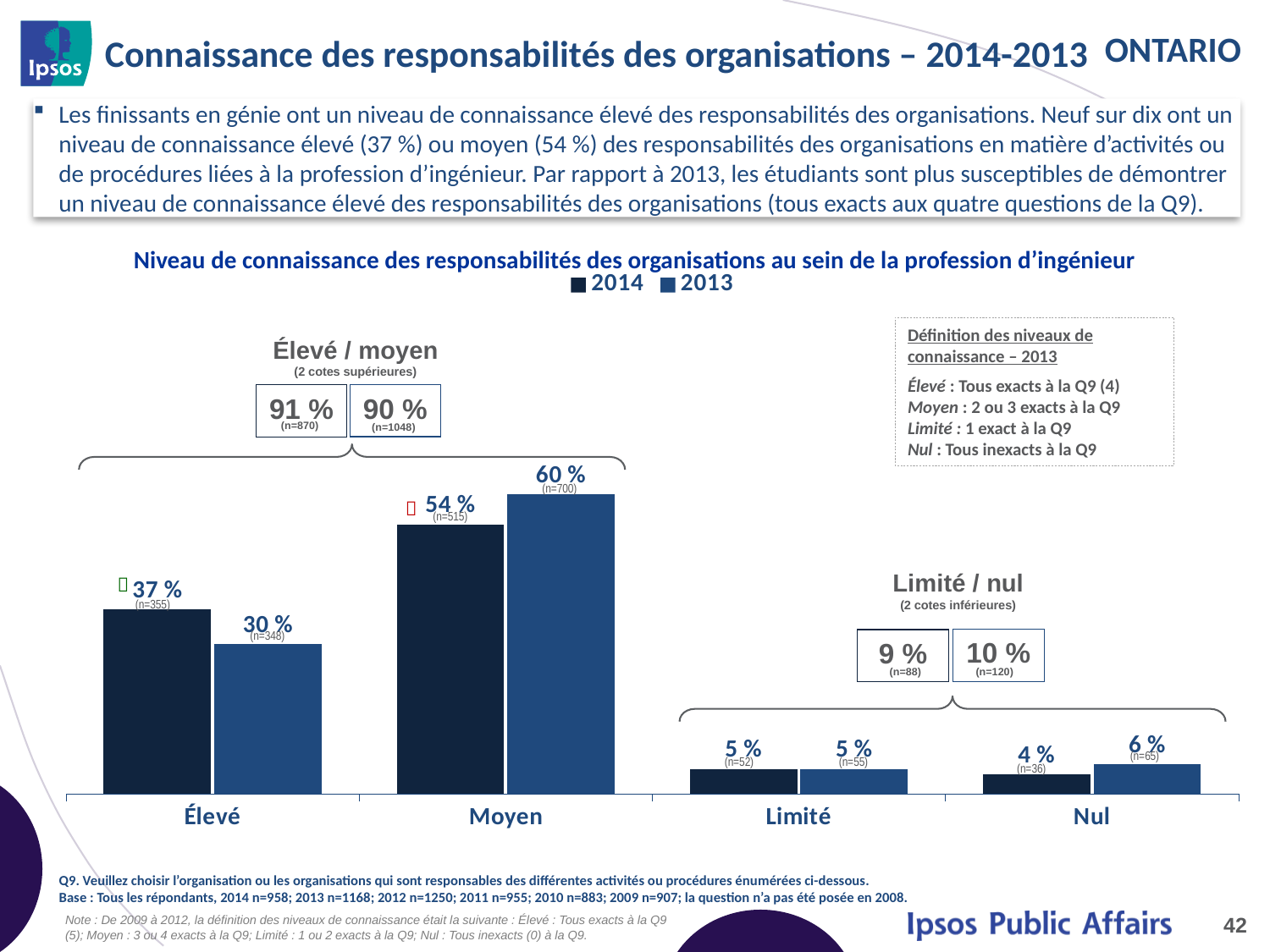
How many categories are shown on the x axis? 4 Which category has the lowest value in the 2014 series? Nul What are the two series named in the legend? 2014 and 2013 What kind of chart is shown on the slide? Bar chart What is the value for Nul in the 2013 series? 6 % What is the value for Moyen in the 2014 series? 54 % Which category has the highest value in the 2014 series? Moyen Which is larger for Moyen: the 2014 value or the 2013 value? 2013 What is the difference between the 2014 and 2013 values for Élevé? 7 % How many series does the legend list? 2 What is the value for Élevé in the 2013 series? 30 % What is the difference between the 2013 and 2014 values for Moyen? 6 %